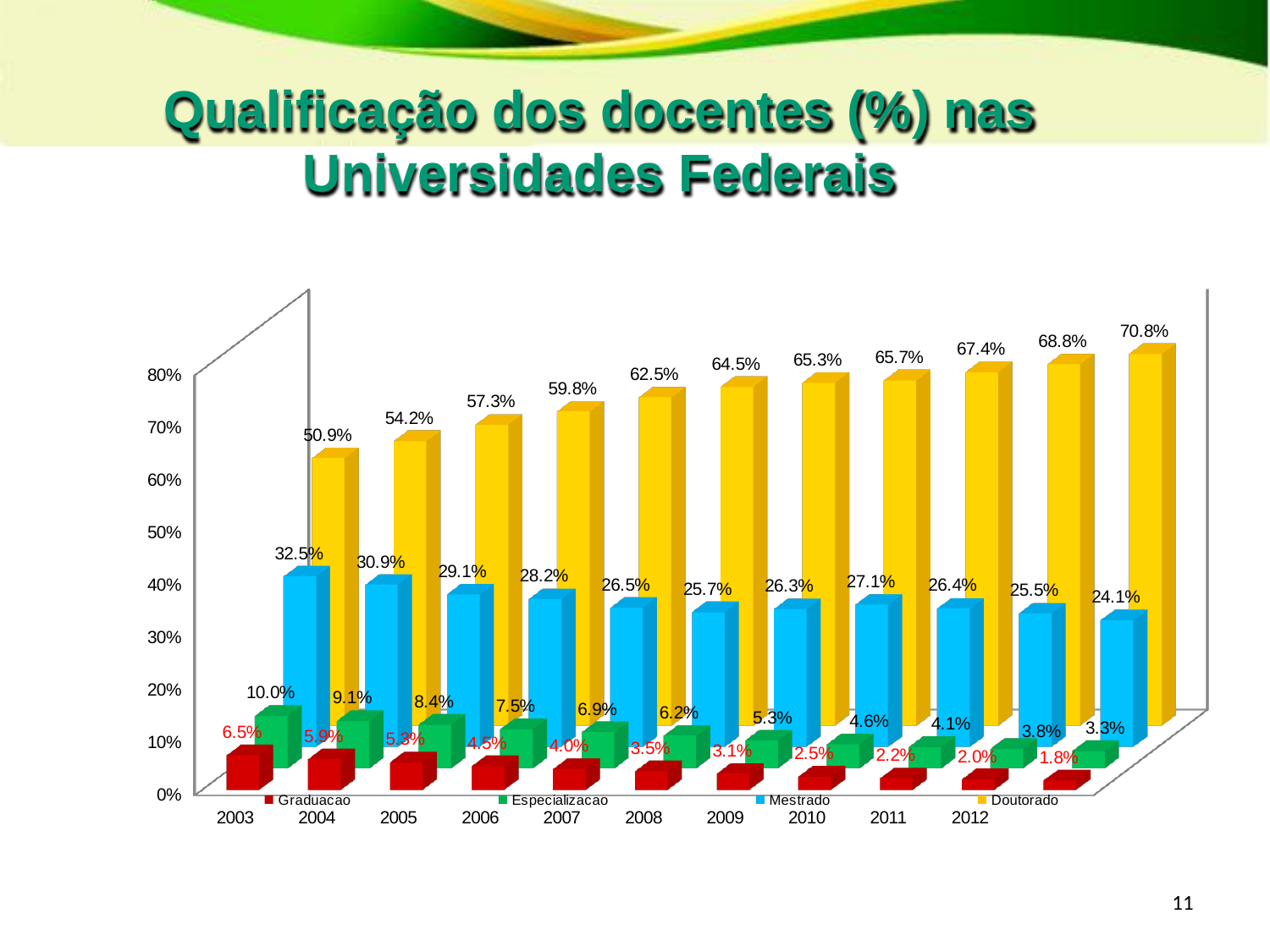
What is the lowest value shown for the Graduacao series? 1.8% What kind of chart is shown on the slide? bar chart How many series does the legend list? 4 Do the Doutorado values rise or fall from left to right along the x axis? rise What is the highest value shown for the Doutorado series? 70.8% Do the Graduacao values rise or fall from left to right along the x axis? fall Which is larger, the leftmost Mestrado value or the leftmost Especializacao value? Mestrado What colour are the Doutorado bars? yellow What is the value of the rightmost Mestrado bar? 24.1% What is the highest value shown for the Mestrado series? 32.5% What is the difference between the rightmost and leftmost Doutorado values? 19.9 percentage points What is the value of the leftmost Doutorado bar? 50.9%